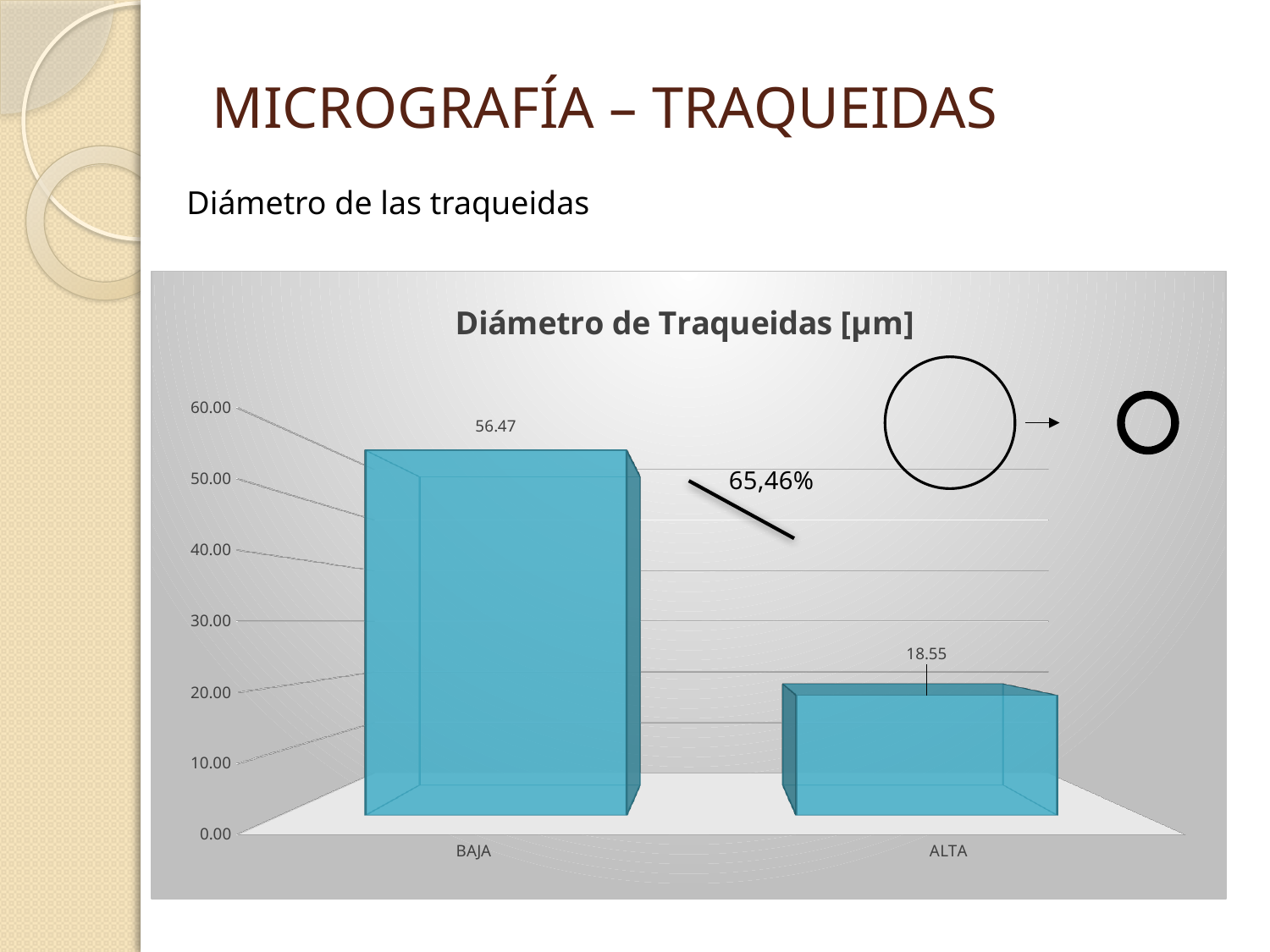
What is the difference between the values for BAJA and ALTA? 37.92 Which is larger, the value for BAJA or the value for ALTA? BAJA What is the value for ALTA? 18.55 Which category has the highest value? BAJA How many categories are shown on the x axis? 2 Which category has the lowest value? ALTA What is the value for BAJA? 56.47 Is the value for ALTA greater or less than 20.00? less Is the value for BAJA greater or less than 50.00? greater What is the title of the chart? Diámetro de Traqueidas [µm] What kind of chart is shown? bar chart What percentage is annotated between the two bars? 65,46%